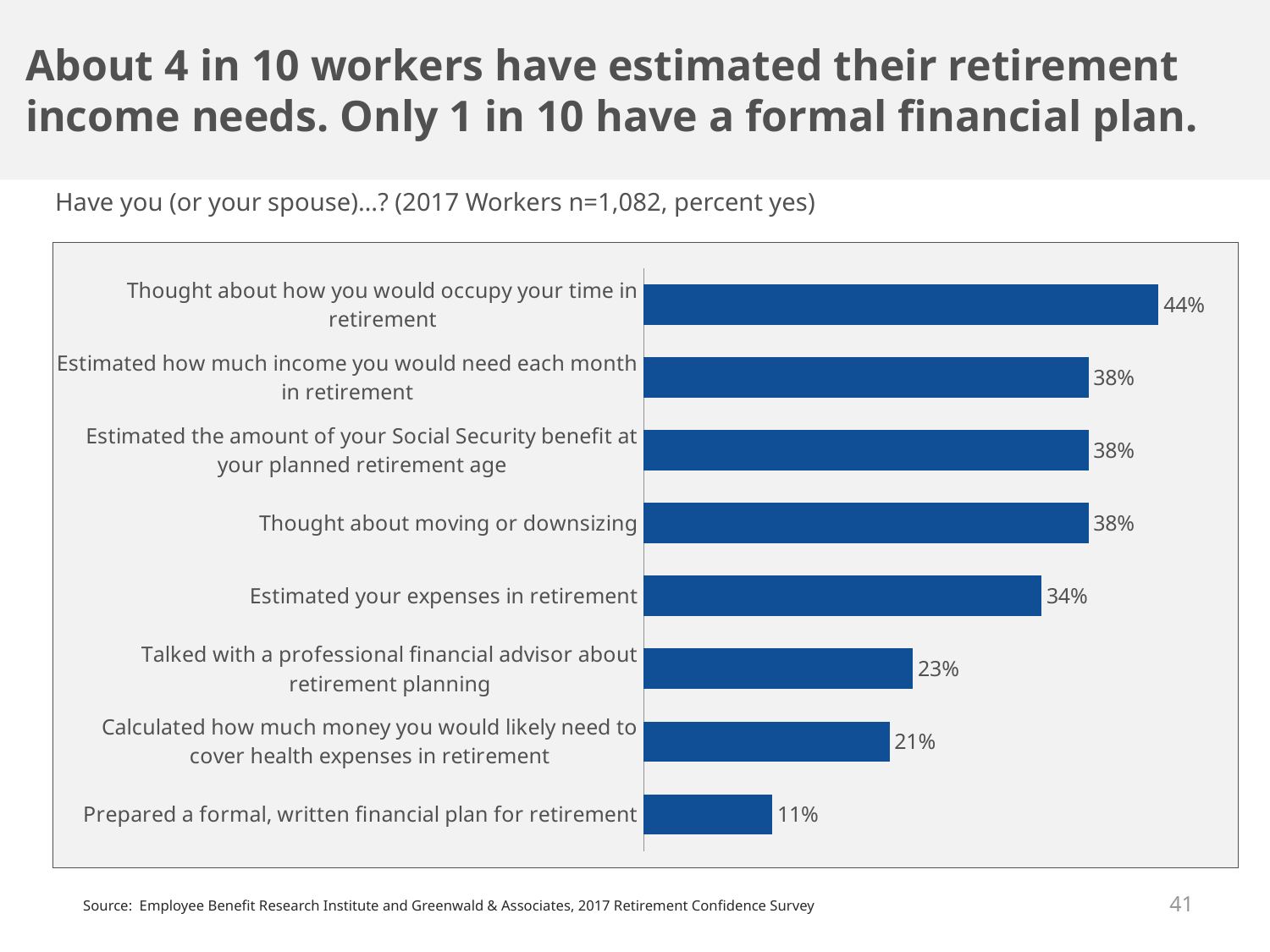
What type of chart is shown on the slide? Bar chart What is the difference in percentage points between workers who estimated their expenses in retirement and those who calculated how much money they would need to cover health expenses in retirement? 13 Which activity has the lowest percentage of workers answering yes? Prepared a formal, written financial plan for retirement What is the sample size of workers shown in the chart subtitle? n=1,082 What percentage of workers have prepared a formal, written financial plan for retirement? 11% What percentage of workers have estimated their expenses in retirement? 34% What is the difference in percentage points between workers who thought about how they would occupy their time in retirement and those who prepared a formal, written financial plan? 33 What percentage of workers have thought about how they would occupy their time in retirement? 44% How many activities are shown in the chart? 8 Which activity has the highest percentage of workers answering yes? Thought about how you would occupy your time in retirement Which is larger: the percentage who talked with a professional financial advisor or the percentage who thought about moving or downsizing? Thought about moving or downsizing What percentage of workers have talked with a professional financial advisor about retirement planning? 23%